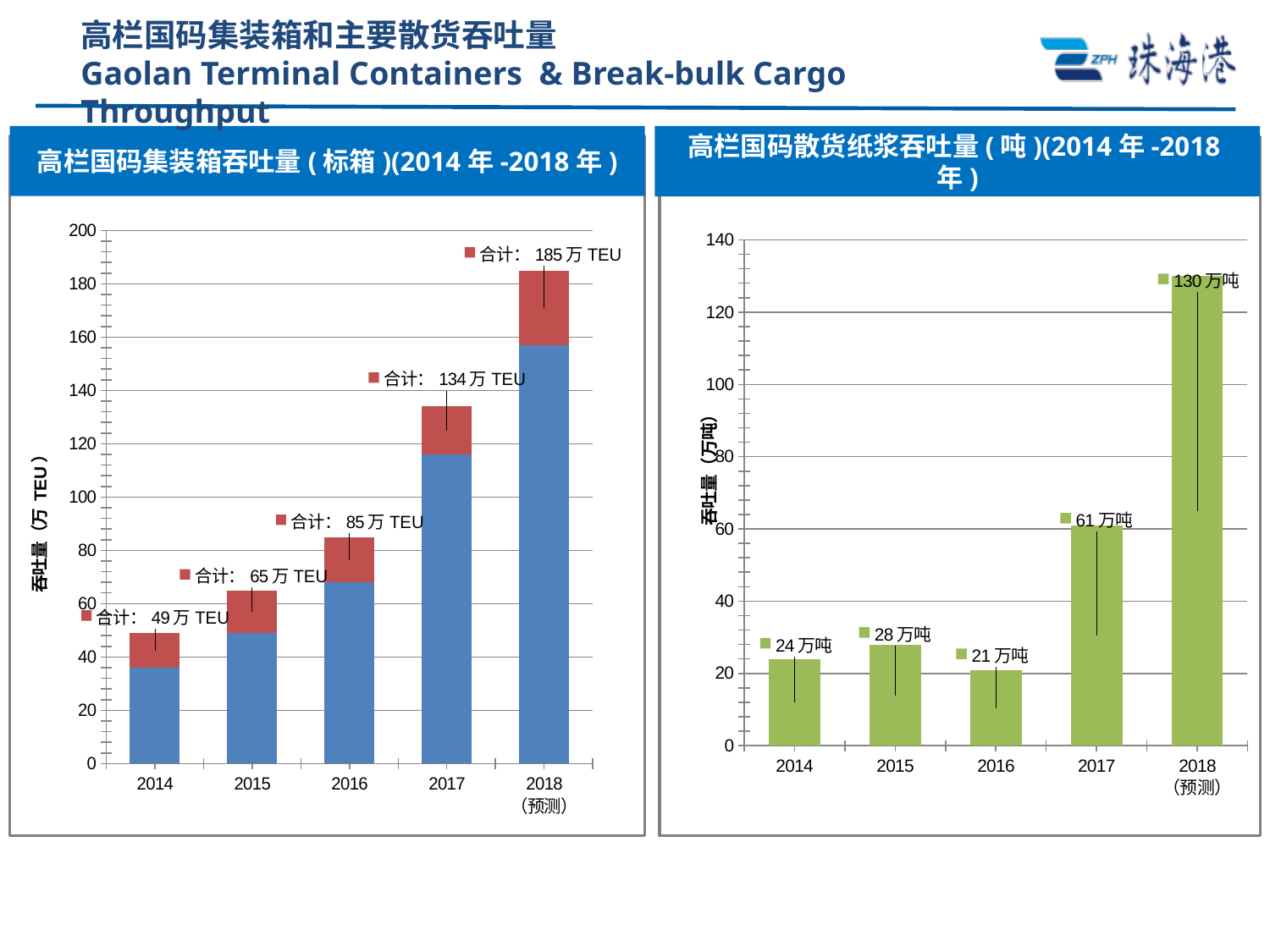
In the right chart (高栏国码散货纸浆吞吐量), what is the value for 2016? 21 万吨 In the right chart (高栏国码散货纸浆吞吐量), what is the difference between the 2018 (预测) value and the 2017 value? 69 万吨 In the left chart (高栏国码集装箱吞吐量), which year has the lowest total throughput? 2014 In the left chart (高栏国码集装箱吞吐量), what is the total container throughput for 2018 (预测)? 185 万 TEU What kind of chart is the right chart (高栏国码散货纸浆吞吐量)? bar chart In the right chart (高栏国码散货纸浆吞吐量), which year has the highest value? 2018 (预测) In the left chart (高栏国码集装箱吞吐量), how many years are shown on the x axis? 5 In the left chart (高栏国码集装箱吞吐量), what is the total container throughput for 2014? 49 万 TEU In the left chart (高栏国码集装箱吞吐量), do the total values rise or fall from 2014 to 2018? rise In the right chart (高栏国码散货纸浆吞吐量), which year has the lowest value? 2016 In the left chart (高栏国码集装箱吞吐量), what is the difference between the 2017 total and the 2016 total? 49 万 TEU In the right chart (高栏国码散货纸浆吞吐量), what is the value for 2017? 61 万吨